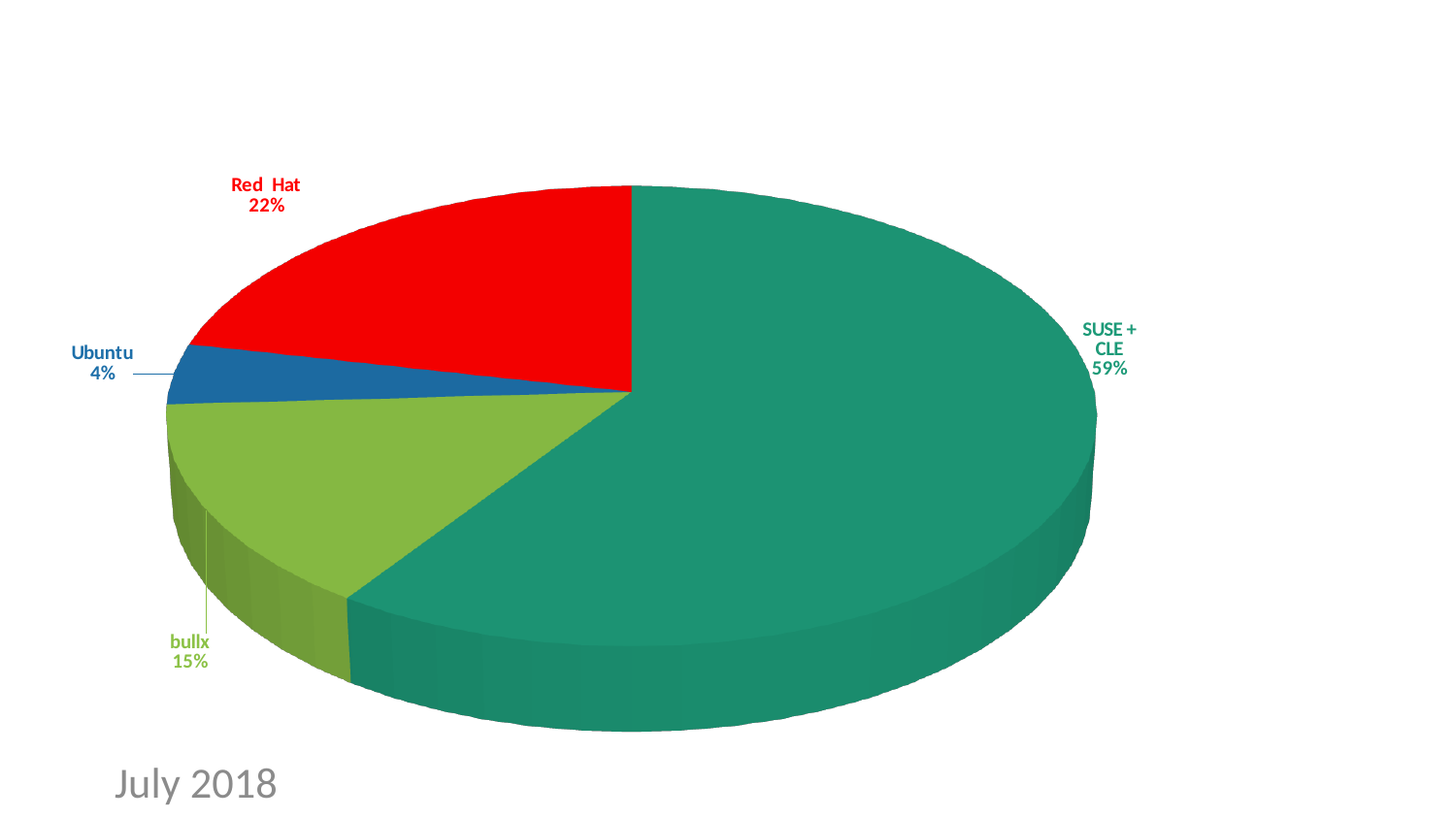
What share of the pie does SUSE + CLE have? 59% What share of the pie does Ubuntu have? 4% What is the difference in percentage points between SUSE + CLE and Red Hat? 37 What colour is the Red Hat slice? red Which category has the smallest slice of the pie? Ubuntu What share of the pie does bullx have? 15% Which category has the largest slice of the pie? SUSE + CLE What is the difference in percentage points between bullx and Ubuntu? 11 How many slices does the pie chart have? 4 What kind of chart is shown on the slide? pie chart Which is larger, the share for Red Hat or the share for bullx? Red Hat